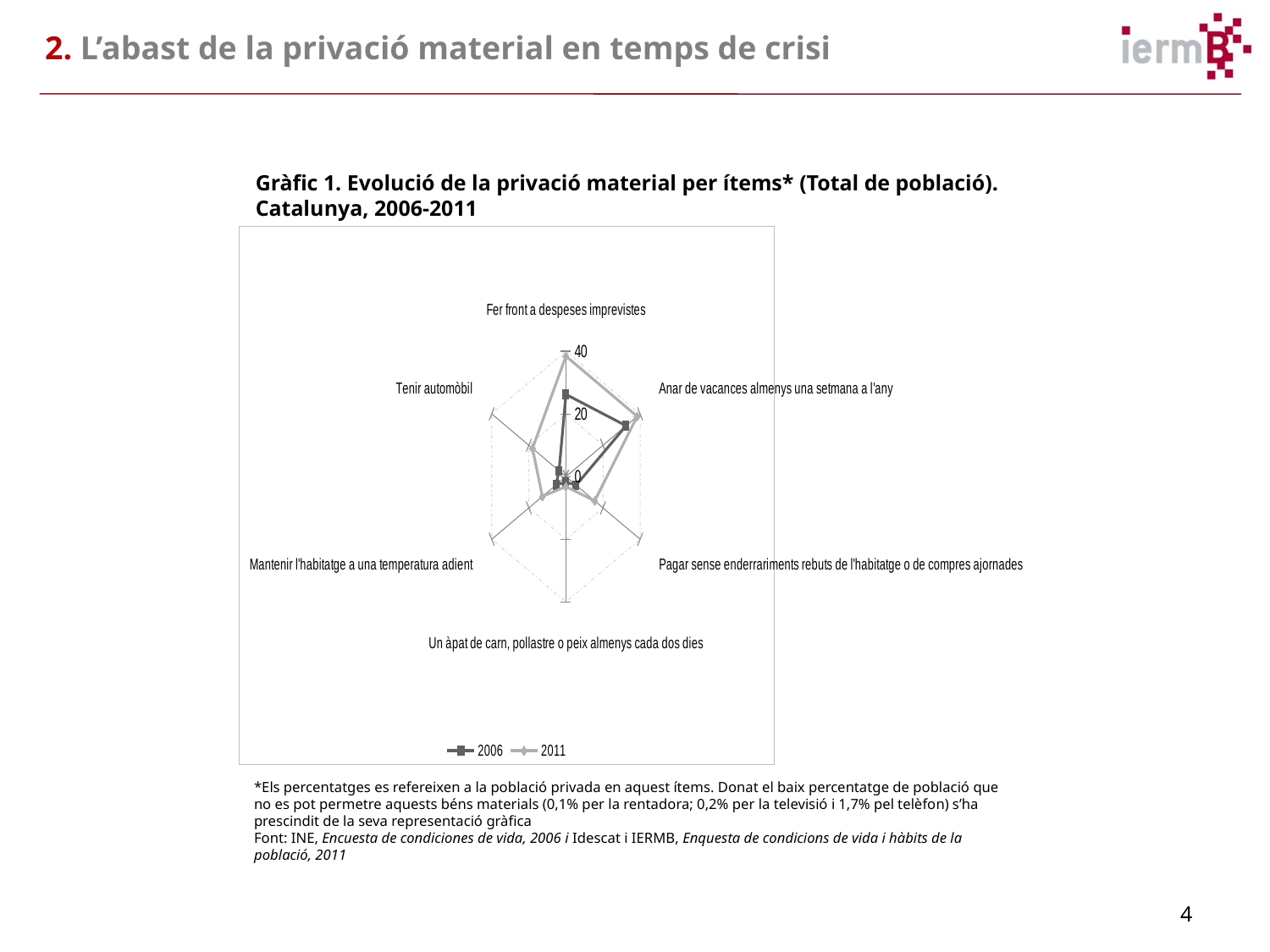
What kind of chart is shown on the slide? Radar chart Which item has the highest value for the 2006 series? Anar de vacances almenys una setmana a l'any Which years are listed in the chart legend? 2006 and 2011 Is the 2006 value for 'Tenir automòbil' greater or less than 20? less Is the 2011 value for 'Anar de vacances almenys una setmana a l'any' greater or less than 20? greater Is the 2011 value for 'Fer front a despeses imprevistes' greater or less than 20? greater For 'Tenir automòbil', which series has the larger value, 2006 or 2011? 2011 How many items (categories) are plotted on the radar chart? 6 What is the highest value shown on the radar chart's axis scale? 40 How many series does the legend list? 2 For 'Fer front a despeses imprevistes', which series has the larger value, 2006 or 2011? 2011